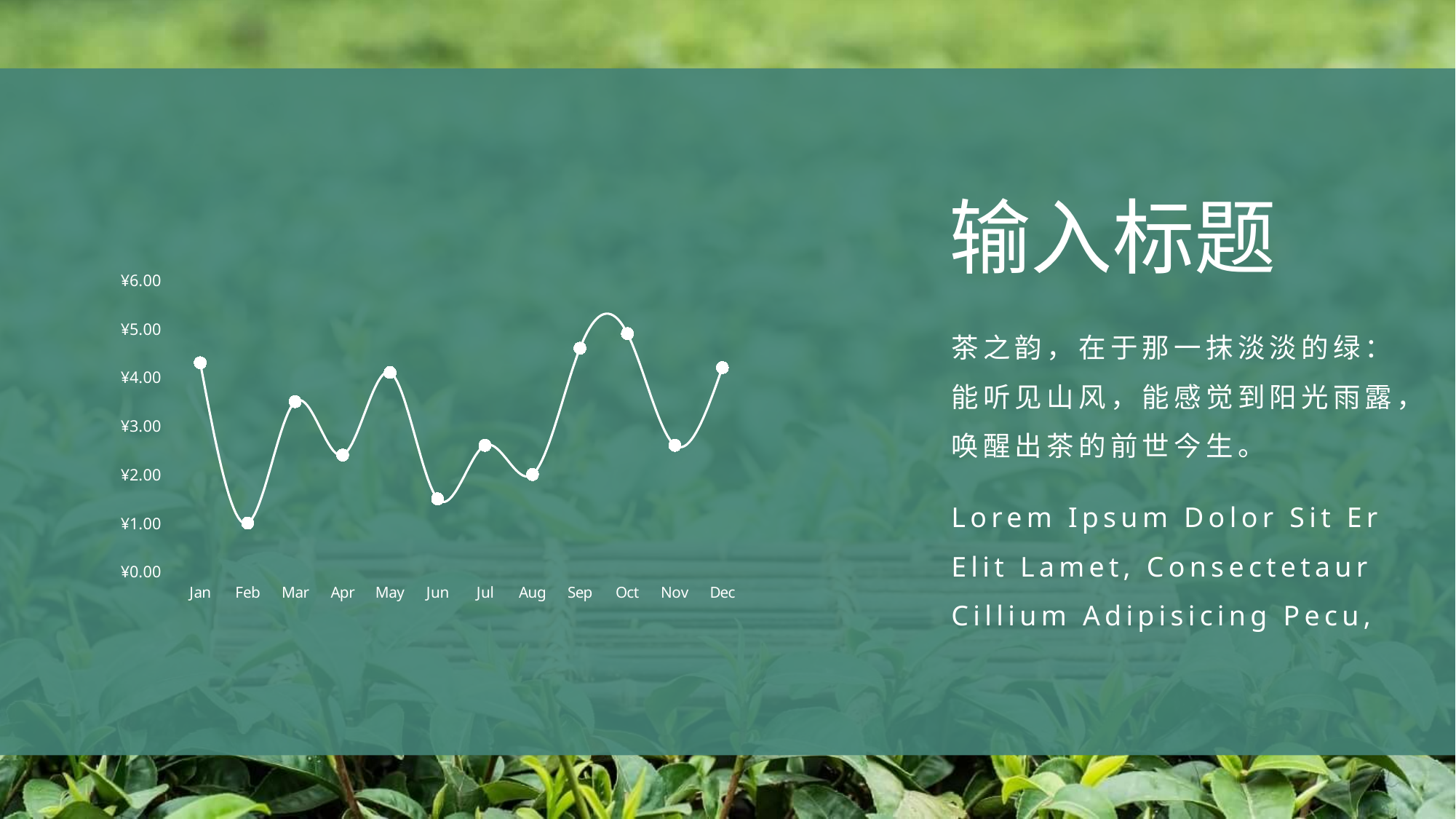
How many months are plotted on the x axis of the chart? 12 Is the value for Mar greater or less than ¥3.00? greater Is the value for Jan greater or less than ¥4.00? greater Which month has the lowest value on the chart? Feb Is the value for Feb greater or less than ¥2.00? less Does the line rise or fall from Jan to Feb? fall What kind of chart is shown on the slide? line chart Which is larger, the value for Sep or the value for Aug? Sep What currency symbol is used on the y axis of the chart? ¥ Which month has the highest value on the chart? Oct